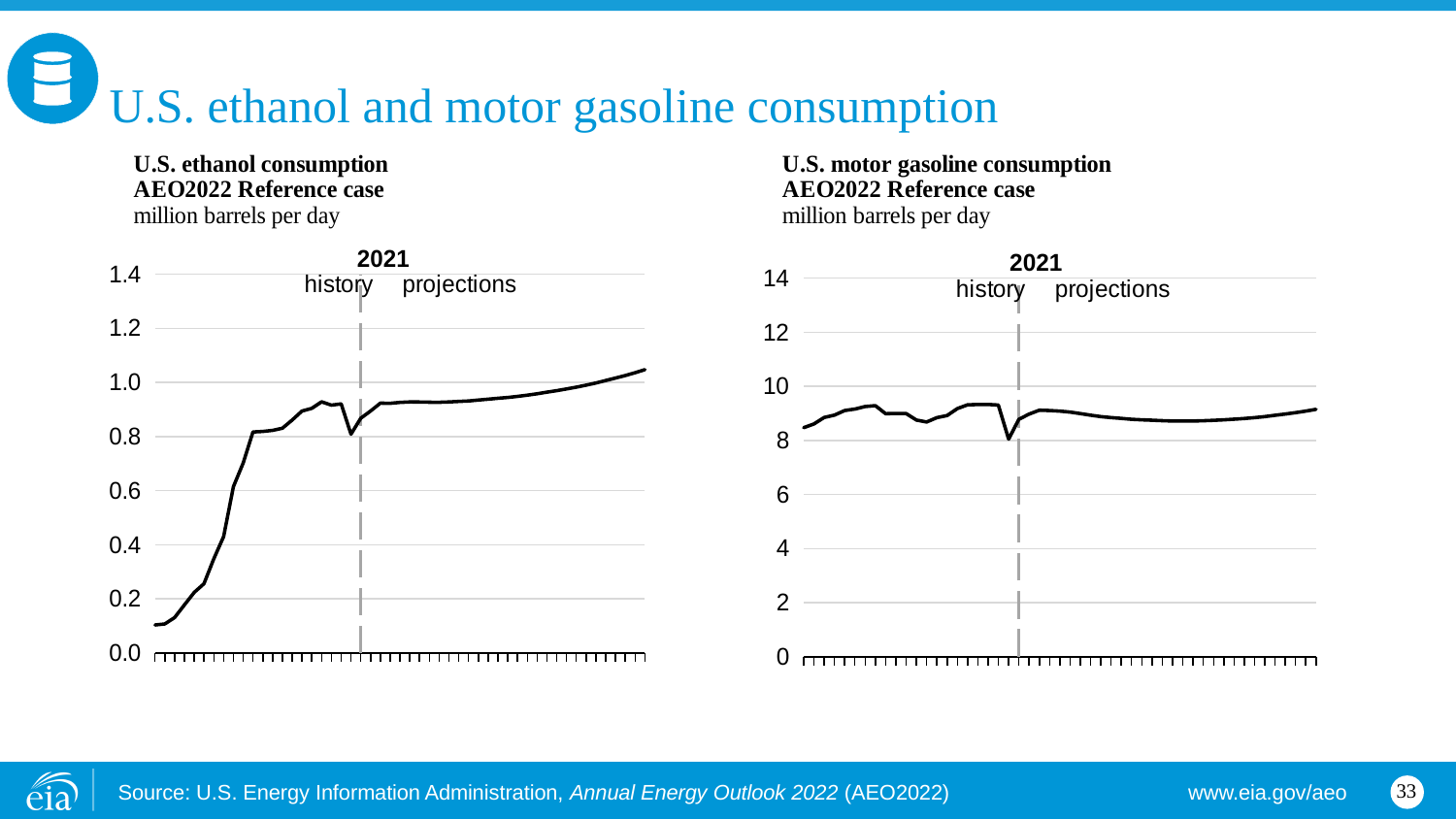
What type of chart is the U.S. ethanol consumption chart on the left? line chart What unit of measurement is used on both charts? million barrels per day What type of chart is the U.S. motor gasoline consumption chart on the right? line chart In the U.S. motor gasoline consumption chart, is the value at the 2021 dashed line greater or less than 10? less Which year does the vertical dashed line separating history from projections mark on both charts? 2021 In the U.S. ethanol consumption chart, do values rise or fall across the projections period? rise In the U.S. motor gasoline consumption chart, is the lowest point of the line greater or less than 12? less In the U.S. ethanol consumption chart, is the value at the start of the history period greater or less than 0.2? less In the U.S. ethanol consumption chart, do values generally rise or fall across the history period? rise